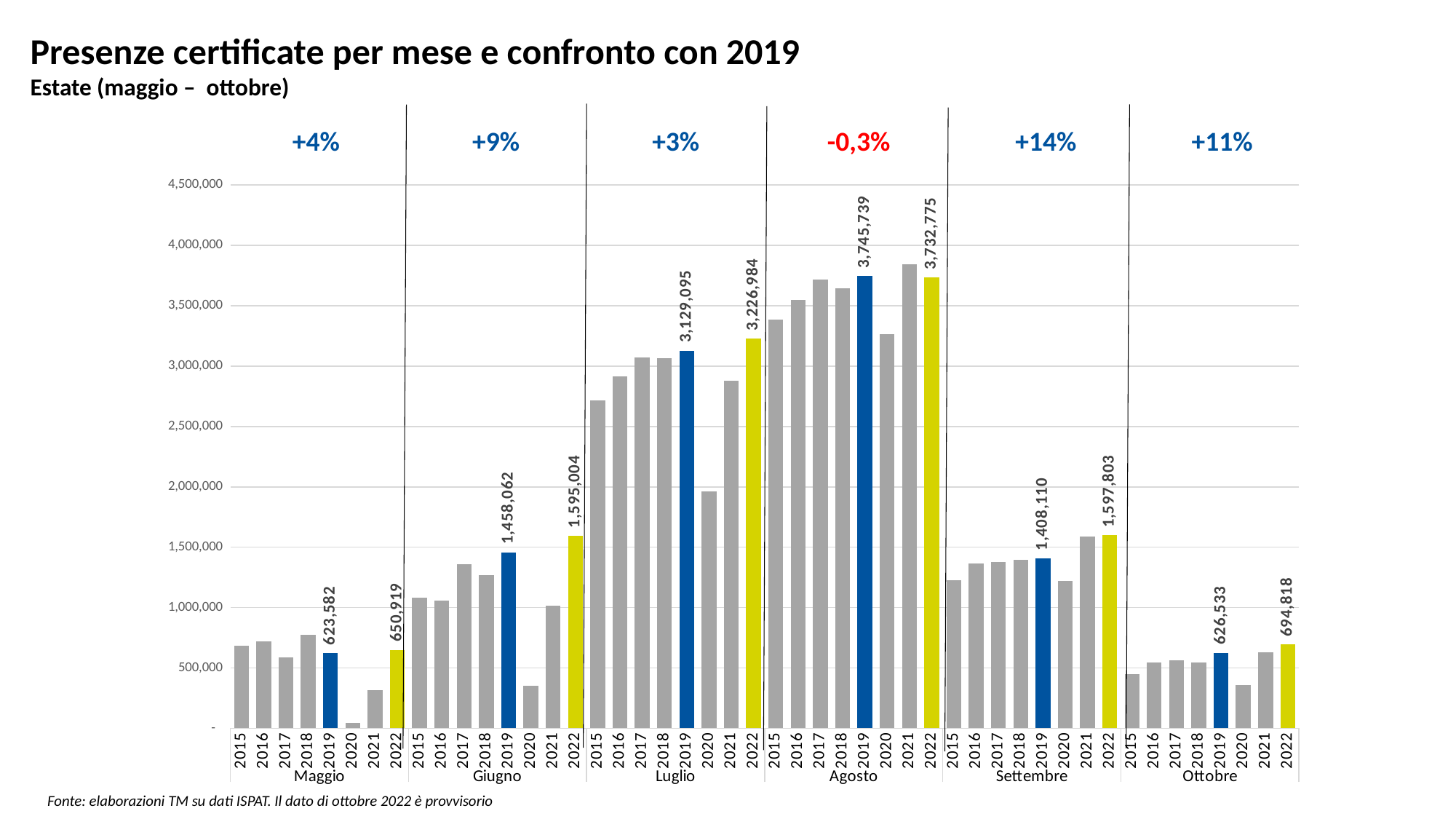
Which month has the highest 2022 value? Agosto What is the value for 2019 in Ottobre? 626,533 What percentage change compared with 2019 is shown above Settembre? +14% What is the difference between the 2019 and 2022 values in Agosto? 12,964 What is the value for 2019 in Agosto? 3,745,739 What kind of chart is shown on the slide? bar chart What is the value for 2022 in Maggio? 650,919 Which month shows a negative percentage change compared with 2019? Agosto What is the value for 2022 in Settembre? 1,597,803 Is the value for 2021 in Agosto greater or less than 3,500,000? greater Which is larger in Settembre, the 2019 value or the 2022 value? 2022 How many months are shown on the x axis? 6